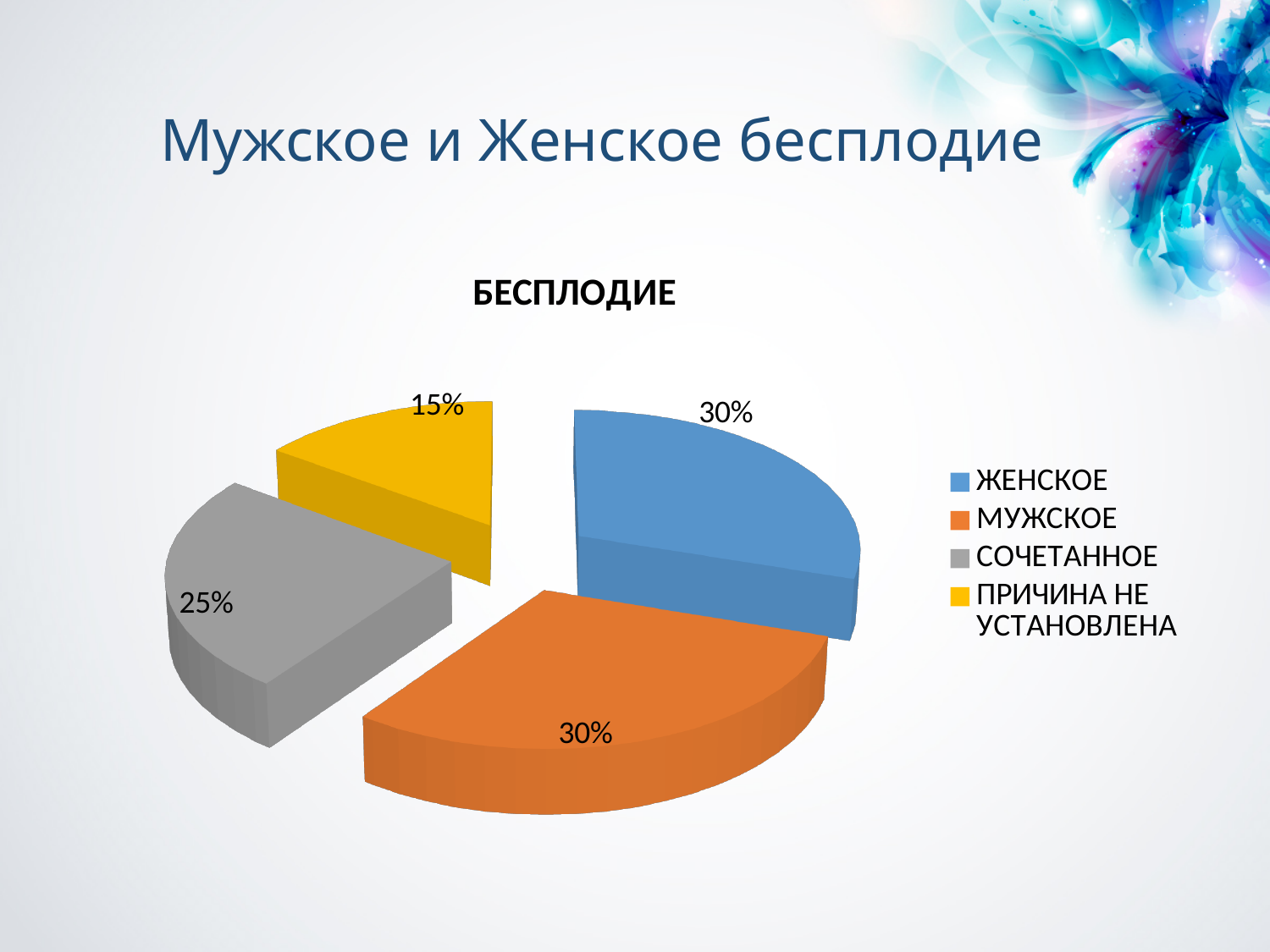
By how many percentage points does the ЖЕНСКОЕ slice exceed the ПРИЧИНА НЕ УСТАНОВЛЕНА slice? 15 What share of the pie does МУЖСКОЕ account for? 30% How many categories are shown in the pie chart? 4 What share of the pie does СОЧЕТАННОЕ account for? 25% What is the title of the chart? БЕСПЛОДИЕ By how many percentage points does the СОЧЕТАННОЕ slice exceed the ПРИЧИНА НЕ УСТАНОВЛЕНА slice? 10 What share of the pie does ПРИЧИНА НЕ УСТАНОВЛЕНА account for? 15% What share of the pie does ЖЕНСКОЕ account for? 30% Which is larger, the slice for СОЧЕТАННОЕ or the slice for ПРИЧИНА НЕ УСТАНОВЛЕНА? СОЧЕТАННОЕ Which category has the smallest slice of the pie? ПРИЧИНА НЕ УСТАНОВЛЕНА Which is larger, the slice for ЖЕНСКОЕ or the slice for СОЧЕТАННОЕ? ЖЕНСКОЕ What kind of chart is shown on the slide? Pie chart